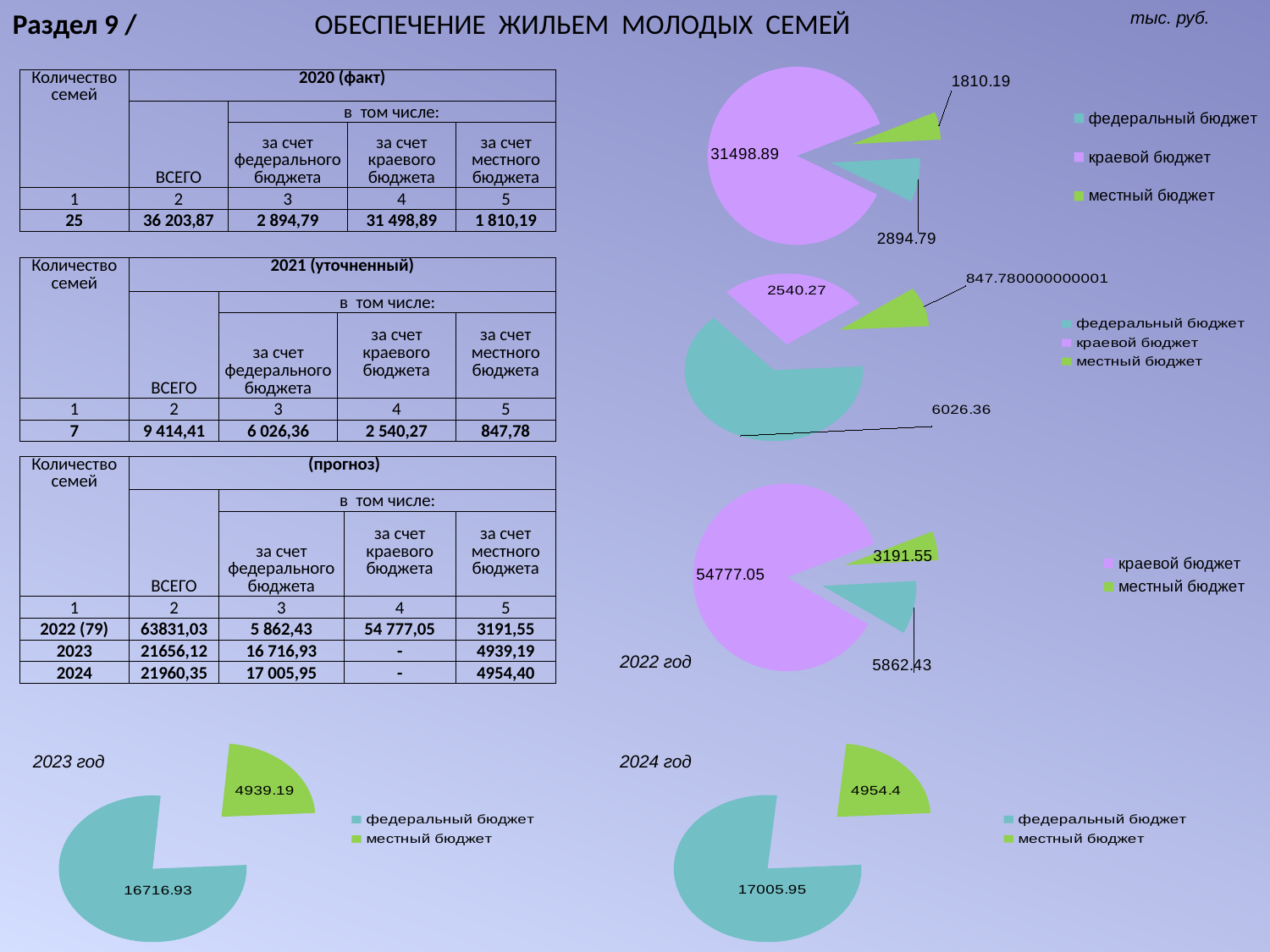
In the top-right pie chart, what is the value of the largest slice? 31498.89 How many slices does the pie chart labelled 2022 год have? 3 In the pie chart labelled 2024 год, what is the value for местный бюджет? 4954.4 In the pie chart labelled 2023 год, what is the difference between the федеральный бюджет value and the местный бюджет value? 11777.74 In the pie chart labelled 2023 год, what is the value for федеральный бюджет? 16716.93 In the pie chart labelled 2022 год, what is the value for краевой бюджет? 54777.05 How many entries does the legend of the pie chart labelled 2023 год list? 2 In the pie chart labelled 2022 год, what is the difference between the краевой бюджет value (54777.05) and the местный бюджет value (3191.55)? 51585.5 How many entries does the legend of the top-right pie chart list? 3 In the pie chart labelled 2024 год, which is larger: федеральный бюджет or местный бюджет? федеральный бюджет What kind of chart is the one labelled 2024 год? Pie chart In the second pie chart on the right (below the top-right one), what is the value of the smallest slice? 847.780000000001